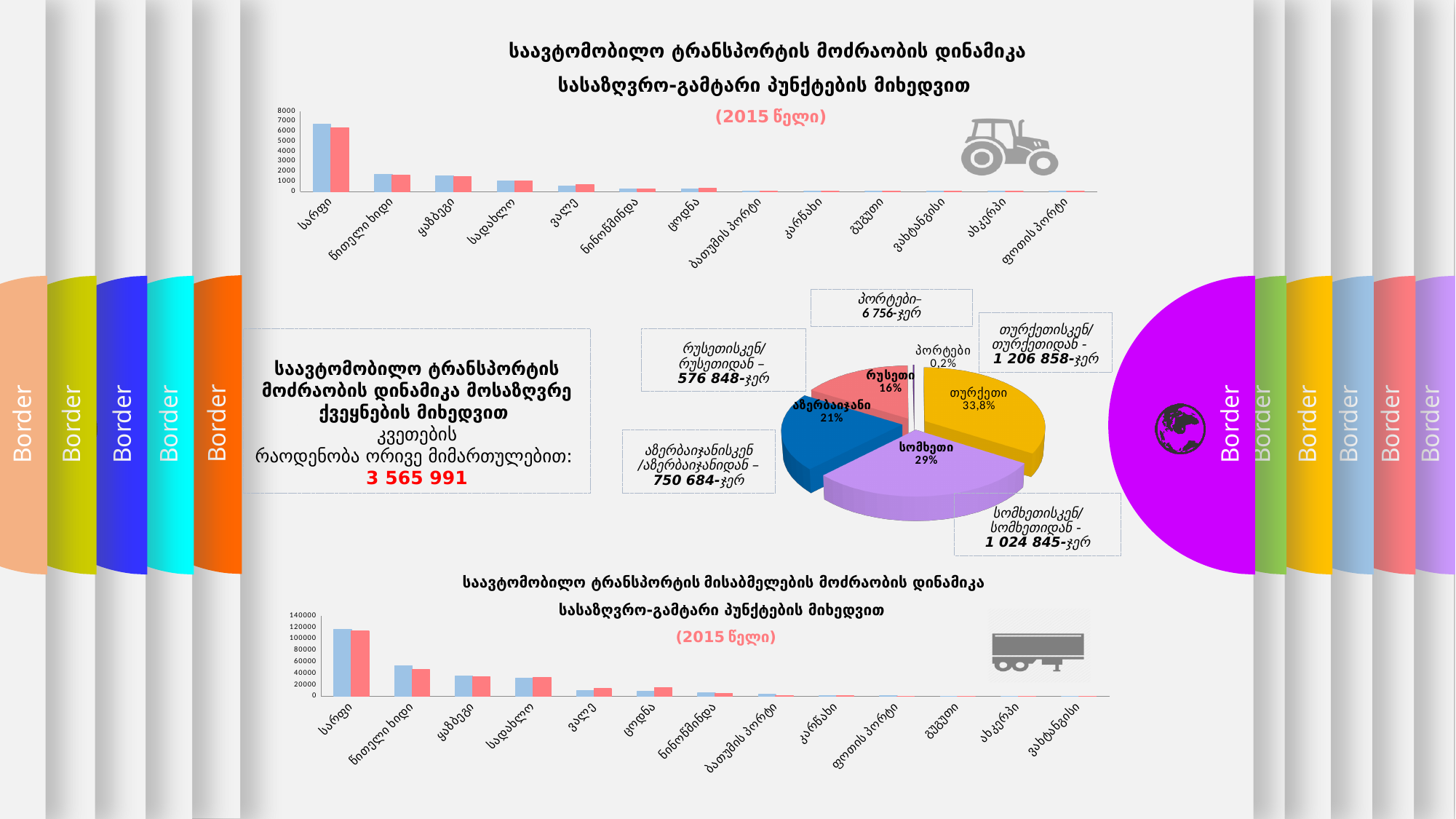
In the pie chart, what is the difference between the values for თურქეთისკენ/თურქეთიდან and სომხეთისკენ/სომხეთიდან? 182 013 In the bottom bar chart, is the value of the first (blue) bar for სარფი greater or less than 100000? greater How many categories are shown on the x axis of the top bar chart? 13 What kind of chart is the middle chart on the slide? pie chart In the top bar chart, which category has the highest bars? სარფი In the top bar chart, is the value of the first (blue) bar for წითელი ხიდი greater or less than 2000? less In the top bar chart, is the value of the first (blue) bar for სარფი greater or less than 5000? greater In the pie chart, what number of crossings is given in the callout for სომხეთისკენ/სომხეთიდან? 1 024 845-ჯერ In the pie chart, what share is shown for თურქეთი? 33,8% In the pie chart, which is larger: the value for აზერბაიჯანისკენ/აზერბაიჯანიდან or for რუსეთისკენ/რუსეთიდან? აზერბაიჯანისკენ/აზერბაიჯანიდან In the pie chart, which slice is the smallest? პორტები What kind of chart is the top chart on the slide? bar chart